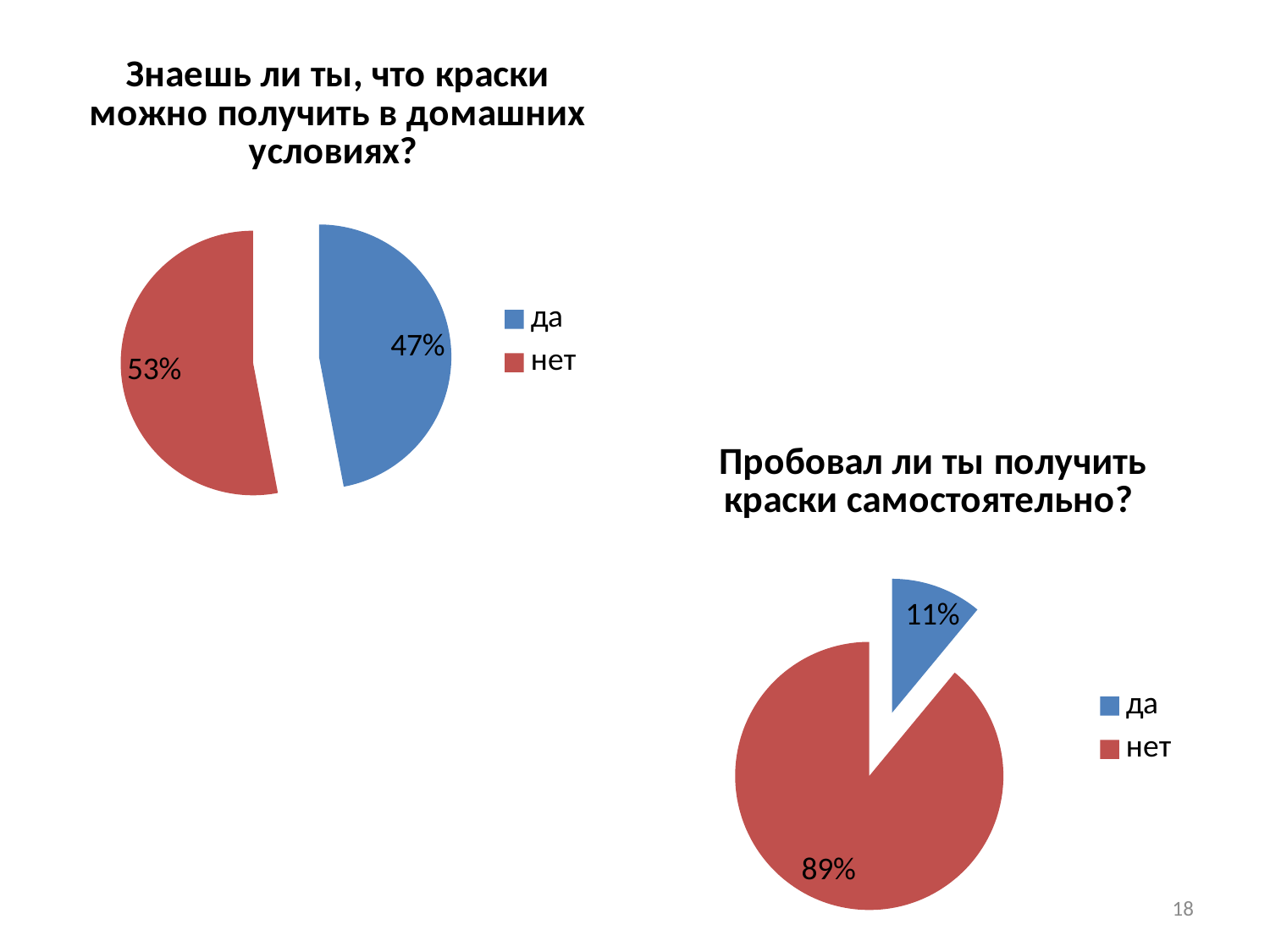
In the chart titled "Пробовал ли ты получить краски самостоятельно?", what share of the pie is "нет"? 89% In the chart titled "Знаешь ли ты, что краски можно получить в домашних условиях?", what share of the pie is "да"? 47% In the chart titled "Знаешь ли ты, что краски можно получить в домашних условиях?", what colour is the "да" slice? Blue In the chart titled "Пробовал ли ты получить краски самостоятельно?", which category has the smallest slice? да In the chart titled "Знаешь ли ты, что краски можно получить в домашних условиях?", what is the difference in percentage points between "нет" and "да"? 6 In the chart titled "Знаешь ли ты, что краски можно получить в домашних условиях?", which category has the larger slice? нет In the chart titled "Знаешь ли ты, что краски можно получить в домашних условиях?", what share of the pie is "нет"? 53% How many categories does the legend of the chart titled "Пробовал ли ты получить краски самостоятельно?" list? 2 In the chart titled "Пробовал ли ты получить краски самостоятельно?", which category has the largest slice? нет In the chart titled "Пробовал ли ты получить краски самостоятельно?", what is the difference in percentage points between "нет" and "да"? 78 What kind of chart is the chart on the top left of the slide? Pie chart